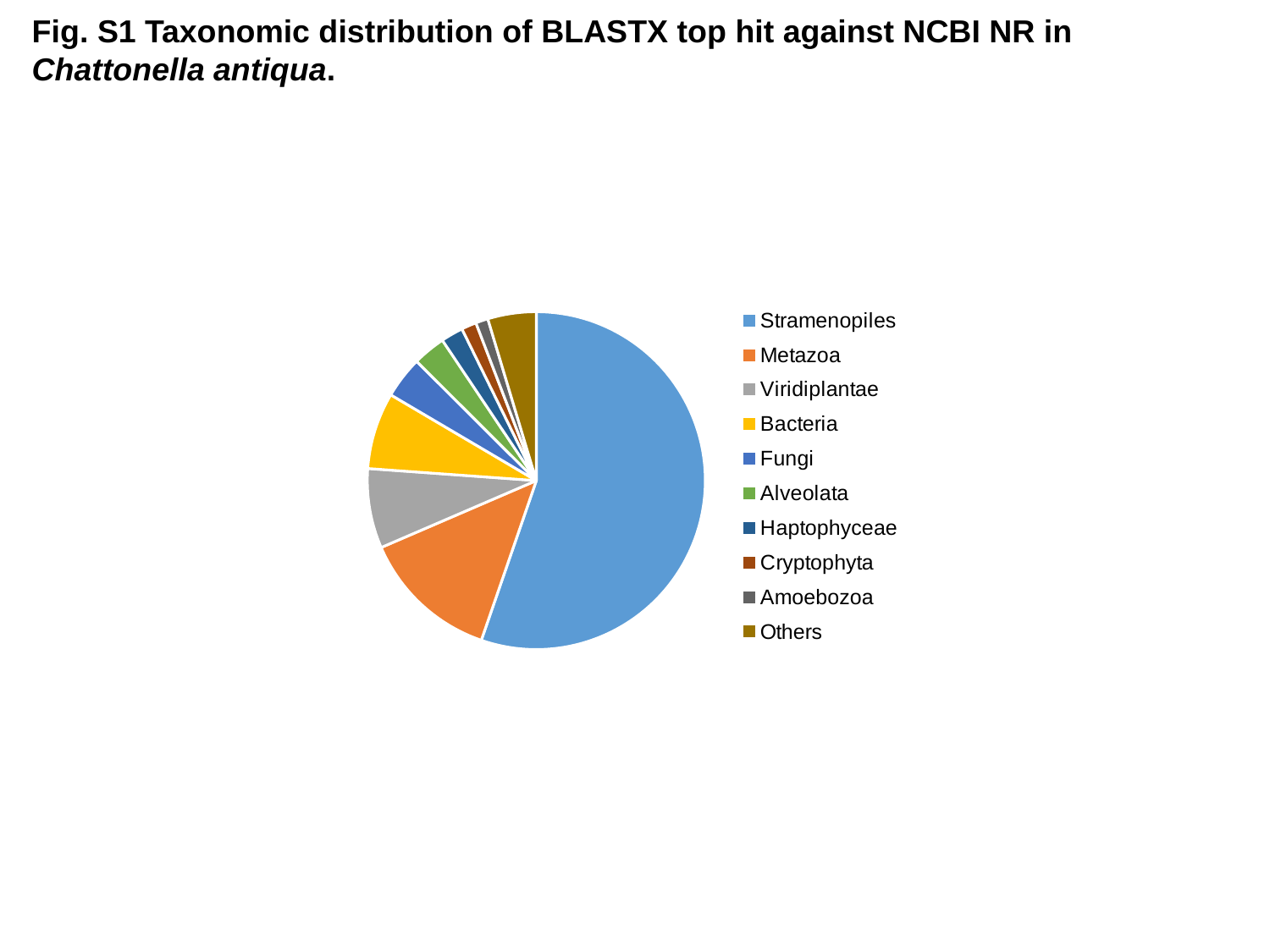
What kind of chart is shown on the slide? Pie chart Which slice is larger, Stramenopiles or Metazoa? Stramenopiles Which slice is larger, Bacteria or Fungi? Bacteria Which category is listed first in the legend? Stramenopiles Which category has the largest slice of the pie chart? Stramenopiles Which slice is larger, Others or Cryptophyta? Others What colour is the Bacteria slice in the pie chart? Yellow How many categories does the pie chart's legend list? 10